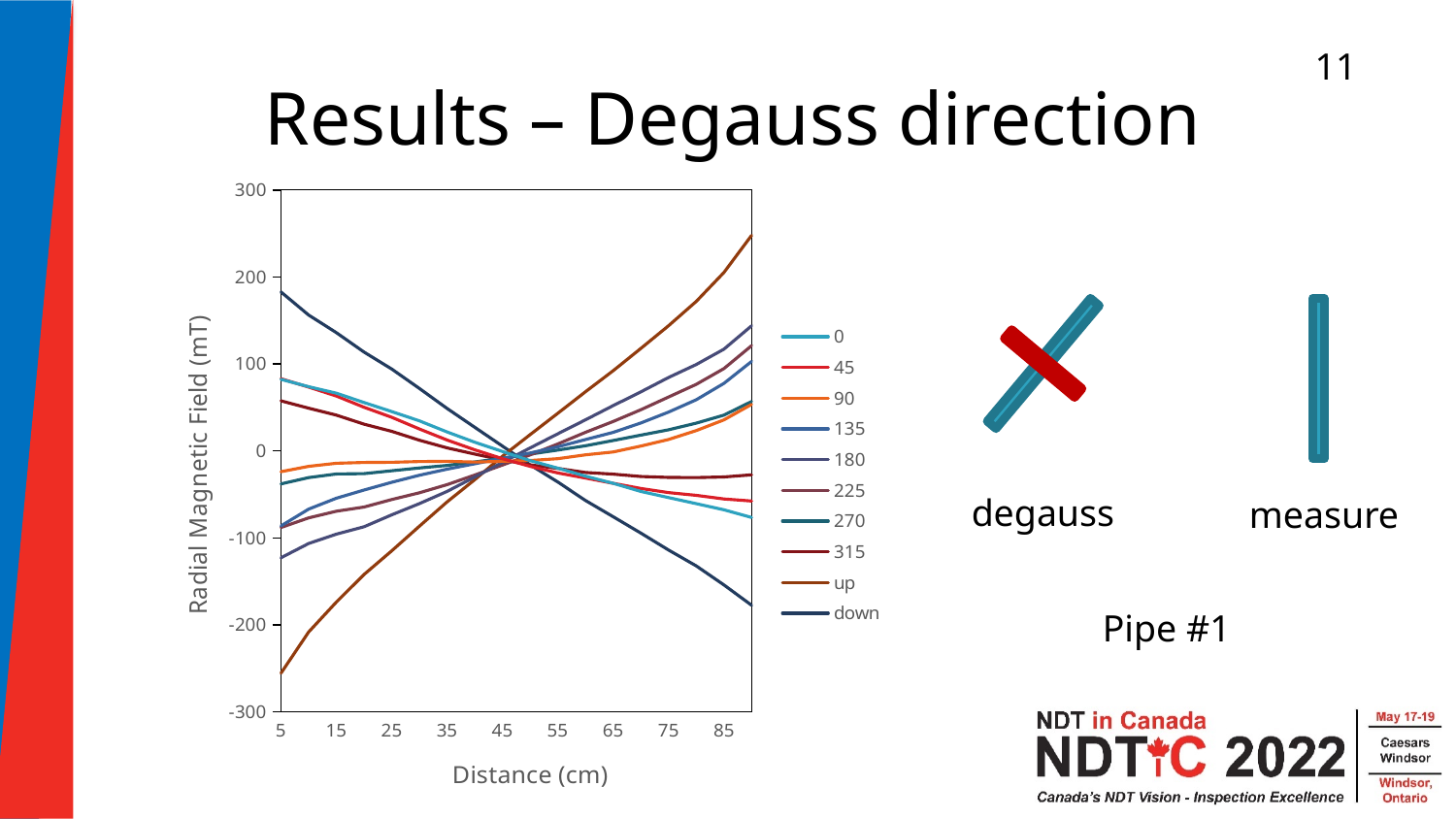
Does the 'up' series rise or fall as distance increases? rises What is the label of the y axis? Radial Magnetic Field (mT) Is the value of the 'up' series at 5 cm greater or less than -200? less Which series has the highest value at the right end of the x axis? up Which series has the lowest value at 5 cm? up At 5 cm, which series has the larger value, 'down' or '0'? down Does the 'down' series rise or fall as distance increases? falls Does the '0' series rise or fall as distance increases? falls What kind of chart is shown on the slide? line chart Is the value of the 'down' series at 5 cm greater or less than 100? greater How many series does the legend list? 10 What is the label of the x axis? Distance (cm)